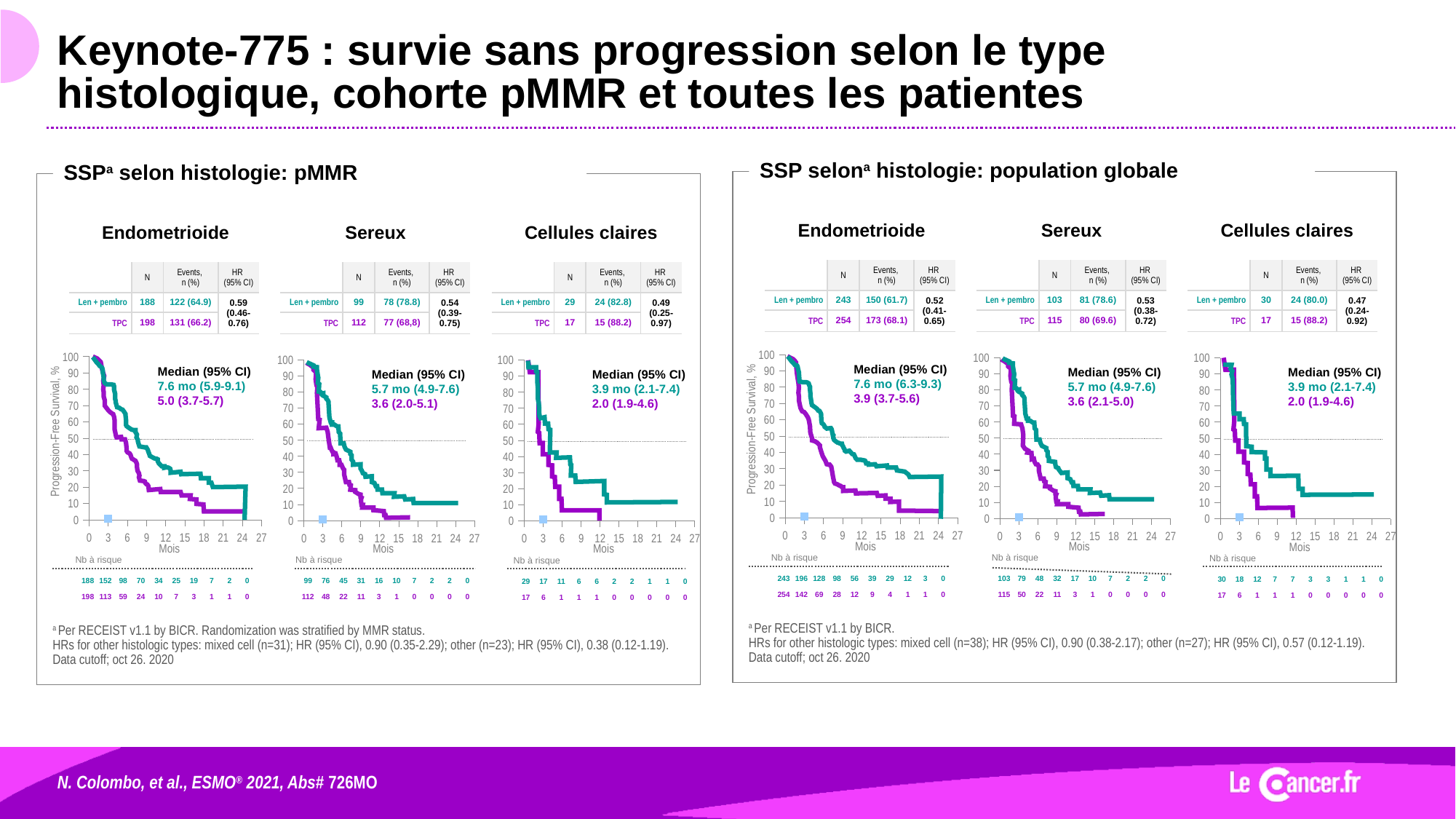
In the pMMR Sereux chart, how many TPC patients are at risk at 0 months? 112 In the pMMR Cellules claires chart, do the curves rise or fall along the x axis? fall In the pMMR Endometrioide chart, what is the median PFS (95% CI) for Len + pembro? 7.6 mo (5.9-9.1) What kind of chart is used in each panel of the slide? Line chart (Kaplan-Meier survival curve) In the pMMR Sereux chart, what is the median PFS (95% CI) for TPC? 3.6 (2.0-5.1) How many curves (treatment arms) are plotted in each chart? 2 In the pMMR Endometrioide chart, how many Len + pembro patients are at risk at 3 months? 152 In the pMMR Endometrioide chart, what is the difference in N between the TPC arm and the Len + pembro arm? 10 In the population globale Endometrioide chart, what is the number of events, n (%), for TPC? 173 (68.1) In the population globale Cellules claires chart, what is the HR (95% CI)? 0.47 (0.24-0.92) In the population globale Sereux chart, which arm has the higher median PFS, Len + pembro or TPC? Len + pembro In the pMMR Endometrioide chart, is the Len + pembro curve at 12 months greater or less than 20? greater